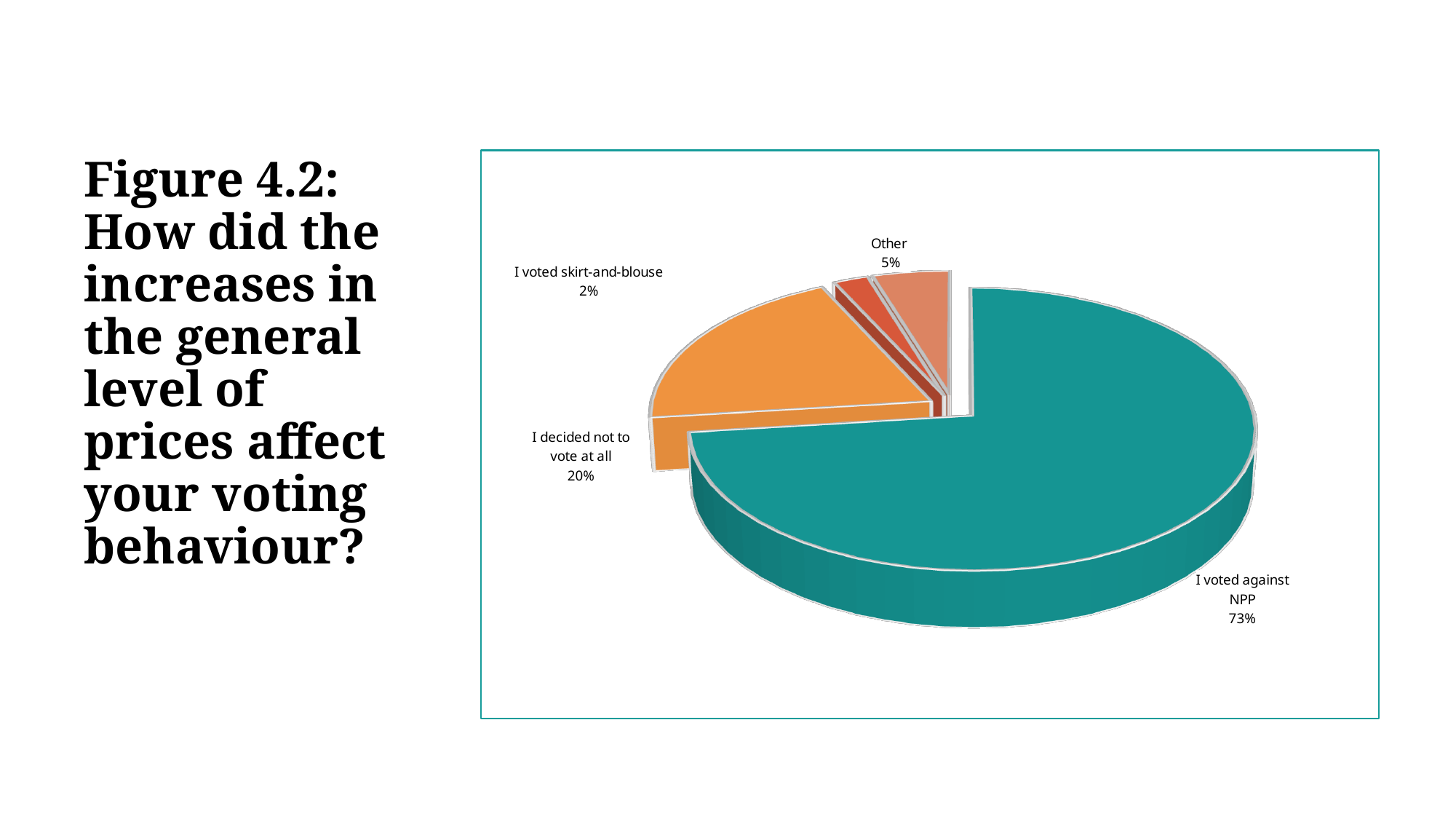
Which category has the largest slice of the pie? I voted against NPP What kind of chart is shown on the slide? Pie chart What colour is the largest slice of the pie? Teal How many slices does the pie chart have? 4 Which is larger: the share for "Other" or the share for "I voted skirt-and-blouse"? Other What share of the pie is labelled "I decided not to vote at all"? 20% Which category has the smallest slice of the pie? I voted skirt-and-blouse What share of the pie is labelled "I voted skirt-and-blouse"? 2% What share of the pie is labelled "Other"? 5% What is the combined share of "Other" and "I voted skirt-and-blouse"? 7% What is the difference in percentage points between "I voted against NPP" and "I decided not to vote at all"? 53